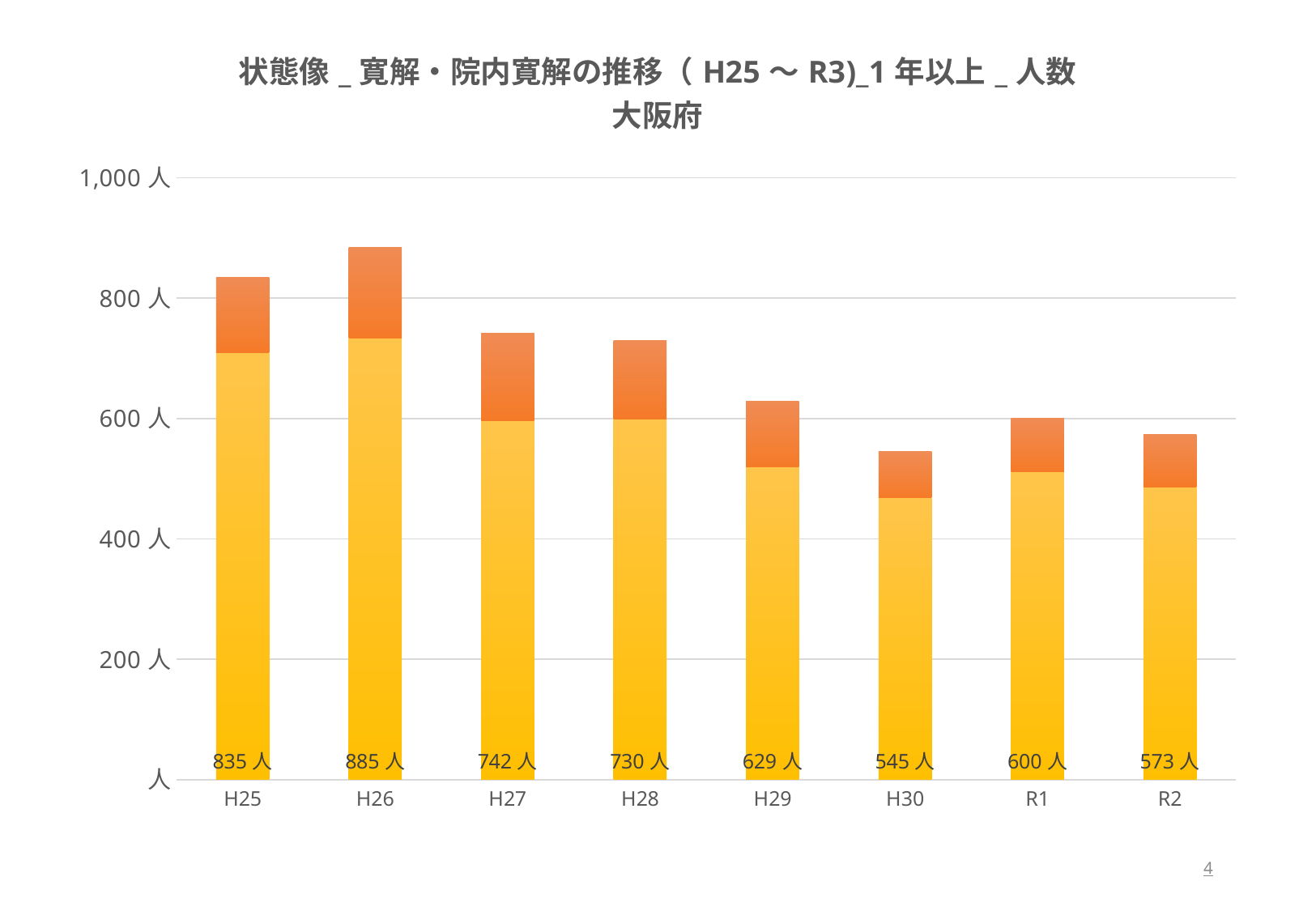
Which is larger, the total for R1 or the total for R2? R1 Do the totals generally rise or fall from H25 to R2? Fall How many years are shown on the x axis? 8 Is the yellow (bottom) segment for H25 greater or less than 600 人? greater What is the difference between the totals for H26 and H25? 50 人 Which year has the lowest total? H30 What is the total value shown for H26? 885 人 What kind of chart is shown on the slide? Stacked bar chart Which year has the highest total? H26 Is the yellow (bottom) segment for H30 greater or less than 600 人? less What is the difference between the totals for R1 and R2? 27 人 What is the total value shown for H30? 545 人